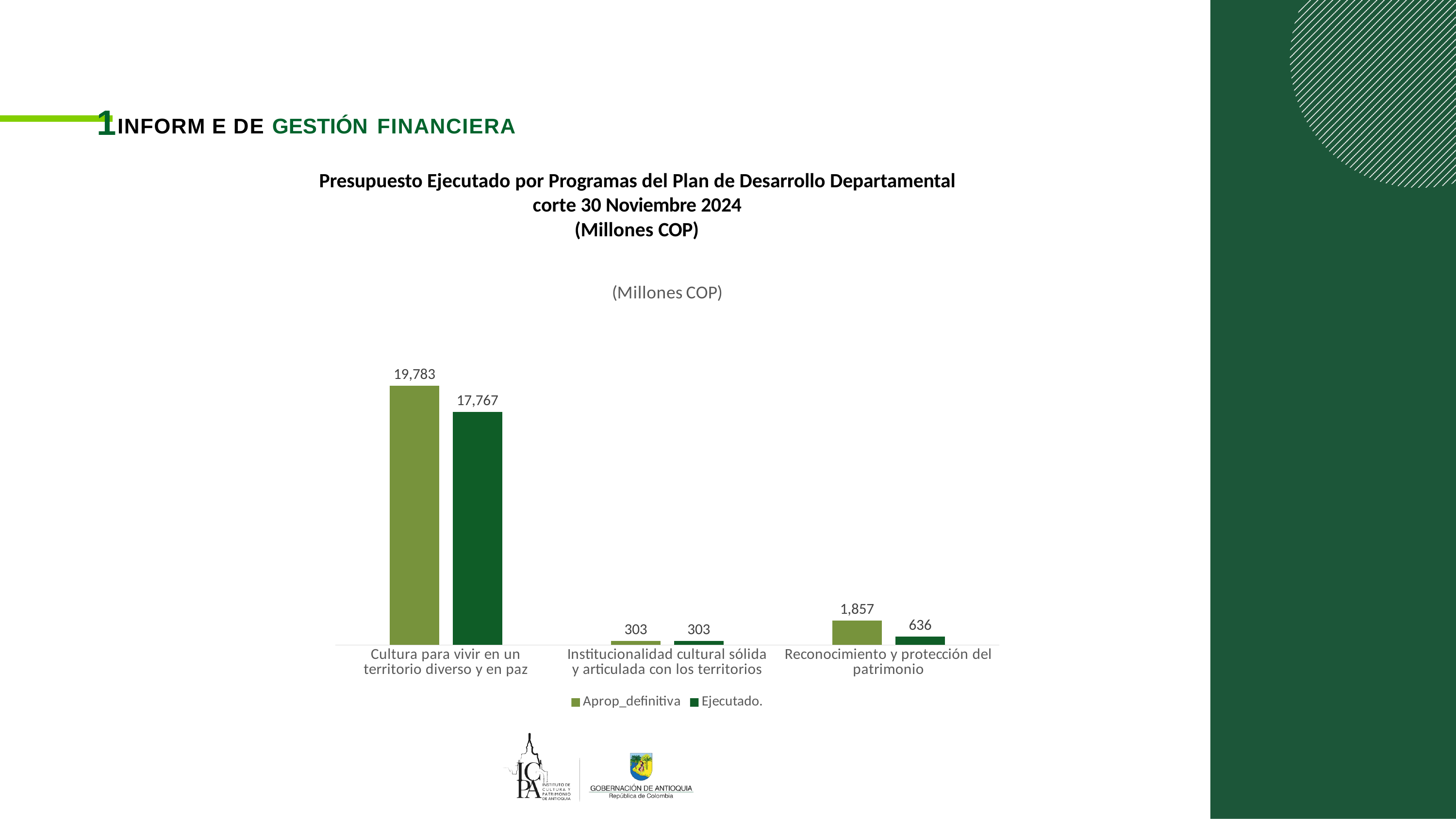
What is the Ejecutado. value for 'Cultura para vivir en un territorio diverso y en paz'? 17,767 How many series does the legend list? 2 Which is larger for 'Reconocimiento y protección del patrimonio': Aprop_definitiva or Ejecutado.? Aprop_definitiva What is the difference between Aprop_definitiva and Ejecutado. for 'Reconocimiento y protección del patrimonio'? 1,221 Which program has the lowest Ejecutado. value? Institucionalidad cultural sólida y articulada con los territorios What is the difference between Aprop_definitiva and Ejecutado. for 'Cultura para vivir en un territorio diverso y en paz'? 2,016 How many programs (categories) are shown on the x axis? 3 What is the Ejecutado. value for 'Reconocimiento y protección del patrimonio'? 636 Which program has the highest Aprop_definitiva value? Cultura para vivir en un territorio diverso y en paz What is the Aprop_definitiva value for 'Reconocimiento y protección del patrimonio'? 1,857 What is the Aprop_definitiva value for 'Cultura para vivir en un territorio diverso y en paz'? 19,783 What is the Ejecutado. value for 'Institucionalidad cultural sólida y articulada con los territorios'? 303